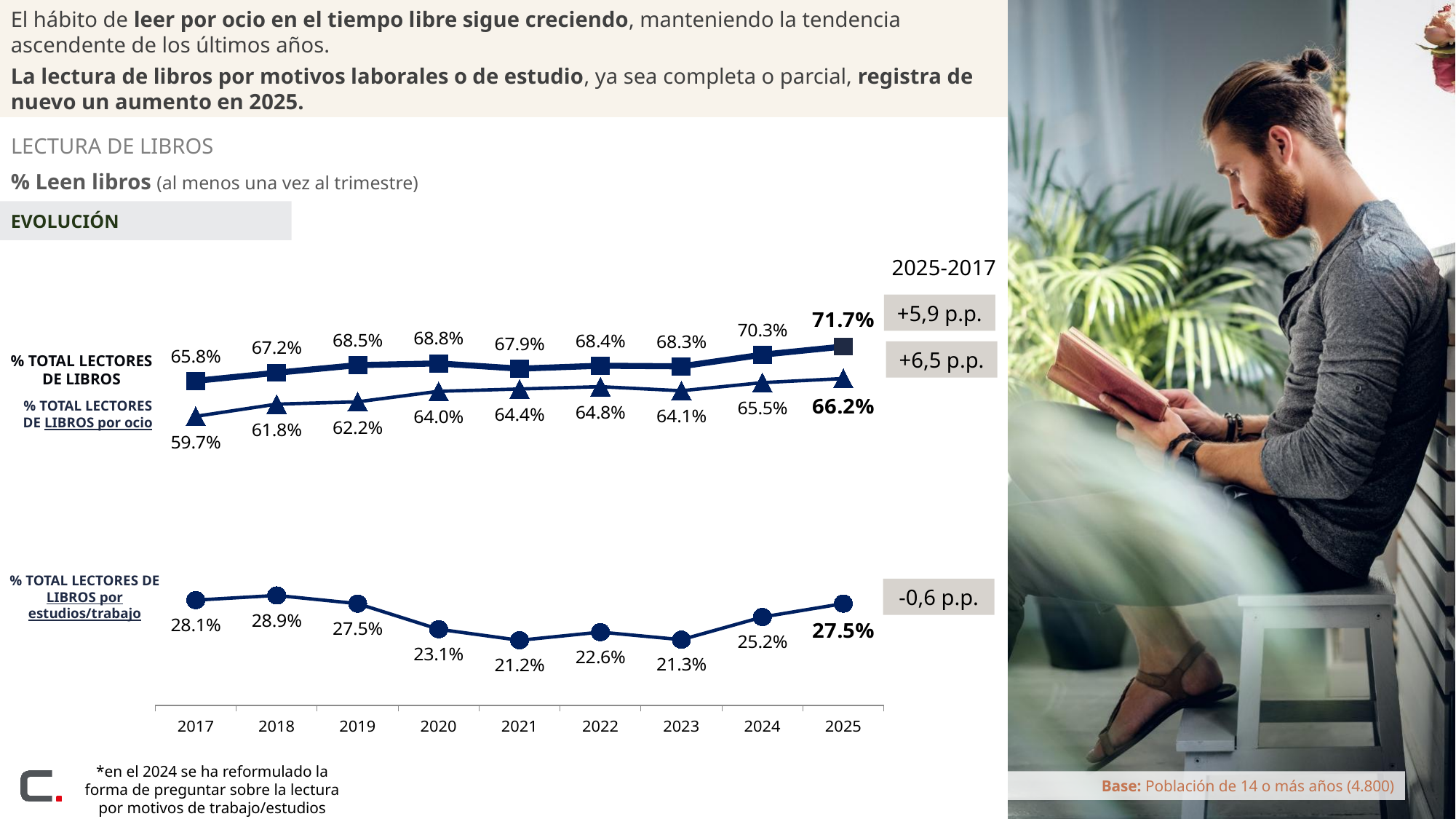
Does % TOTAL LECTORES DE LIBROS por ocio rise or fall from 2017 to 2025? Rise What is the value for % TOTAL LECTORES DE LIBROS por estudios/trabajo in 2021? 21.2% Which is larger: % TOTAL LECTORES DE LIBROS por estudios/trabajo in 2018 or in 2020? 2018 In which year is % TOTAL LECTORES DE LIBROS por estudios/trabajo highest? 2018 What type of chart is shown on the slide? Line chart What change in percentage points is shown for % TOTAL LECTORES DE LIBROS por estudios/trabajo between 2025 and 2017? -0,6 p.p. What is the value for % TOTAL LECTORES DE LIBROS in 2025? 71.7% How many years are shown on the x axis? 9 What is the difference between % TOTAL LECTORES DE LIBROS in 2025 and in 2017? +5,9 p.p. How many series are plotted on the chart? 3 What is the value for % TOTAL LECTORES DE LIBROS por ocio in 2017? 59.7% In which year is % TOTAL LECTORES DE LIBROS por ocio lowest? 2017